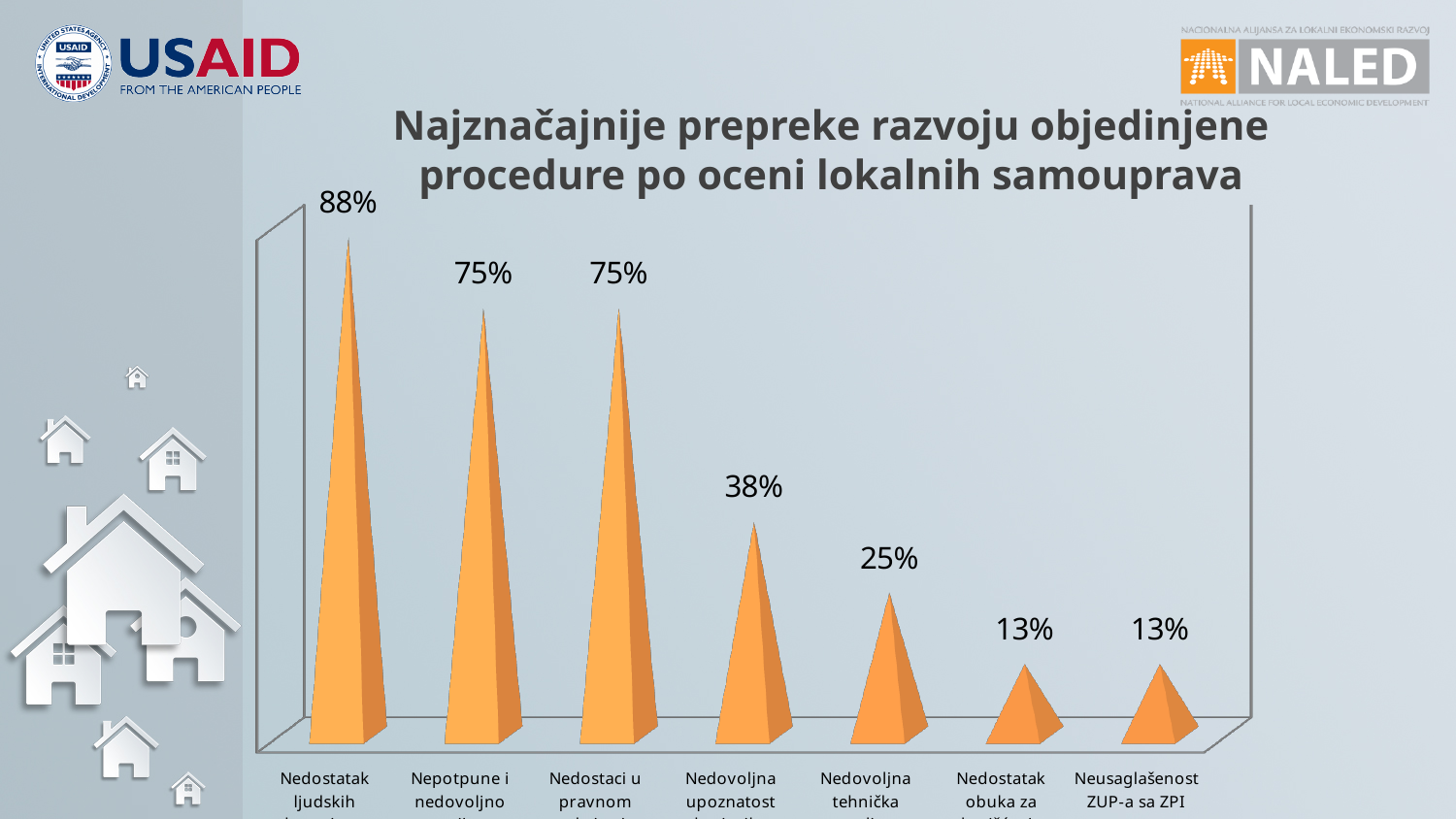
What type of chart is shown on the slide? Bar chart What is the value of the fourth bar from the left, labelled 'Nedovoljna upoznatost...'? 38% What is the lowest value shown in the chart? 13% What is the value of the fifth bar from the left, labelled 'Nedovoljna tehnička...'? 25% What is the difference between the fourth bar (38%) and the fifth bar (25%)? 13% Which category has the highest value in the chart? Nedostatak ljudskih... (the first bar) Do the values rise or fall from left to right across the chart? Fall Which is larger: the value of the fourth bar ('Nedovoljna upoznatost...') or the fifth bar ('Nedovoljna tehnička...')? The fourth bar (38%) What is the value for the category 'Neusaglašenost ZUP-a sa ZPI'? 13% What is the value of the first (leftmost) bar in the chart? 88% What is the difference between the first bar (88%) and the second bar (75%)? 13% How many categories (bars) are shown in the chart? 7